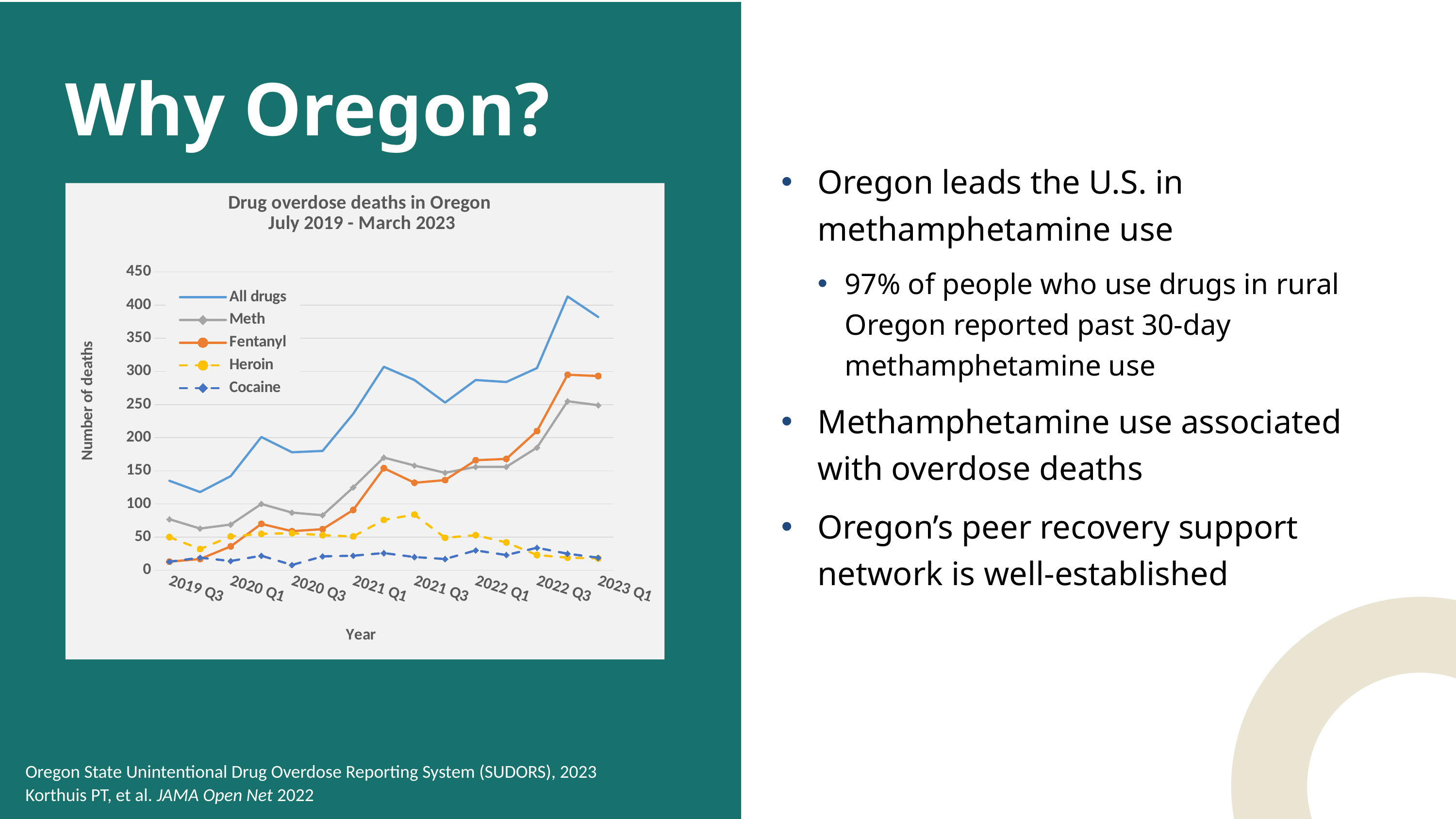
Which series has the highest value at 2023 Q1? All drugs Is the value for Fentanyl at 2022 Q1 greater or less than 150? greater What is the title of the chart? Drug overdose deaths in Oregon July 2019 - March 2023 What is the label on the chart's vertical axis? Number of deaths At 2023 Q1, which is larger, the value for Fentanyl or the value for Meth? Fentanyl Is the value for Cocaine at 2021 Q1 greater or less than 50? less Is the value for All drugs at 2023 Q1 greater or less than 400? less How many series does the chart's legend list? 5 Which series has the lowest value at 2021 Q1? Cocaine Does the All drugs series generally rise or fall from 2019 Q3 to 2023 Q1? rise What kind of chart is shown on the slide? line chart